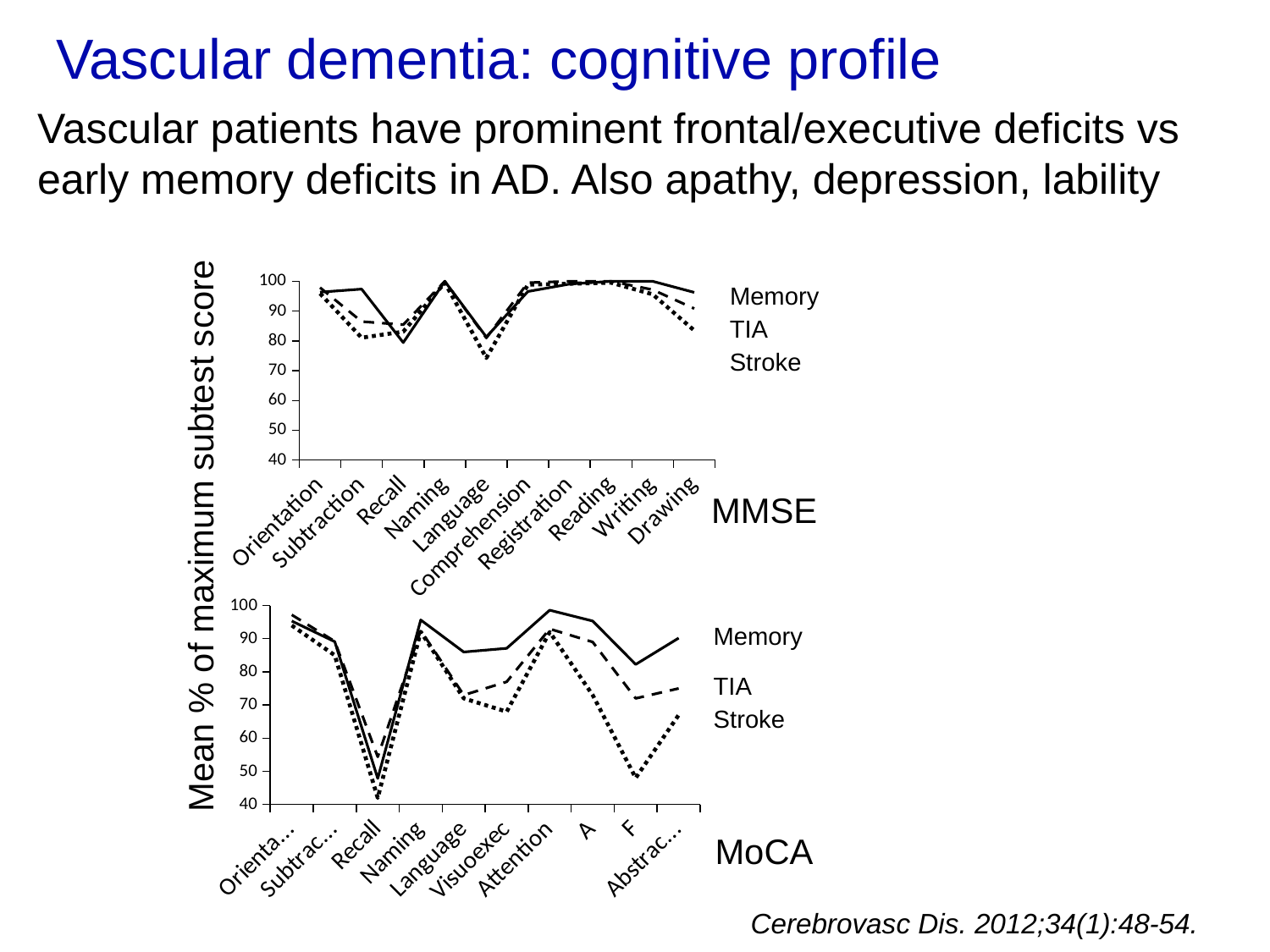
In the MoCA chart, is the Stroke value for Recall greater or less than 50? less In the MMSE chart, which series has the larger value for Language, Memory or Stroke? Memory In the MoCA chart, is the Stroke value for F greater or less than 60? less What is the label on the shared y axis of the two charts? Mean % of maximum subtest score How many subtests are plotted along the x axis of the MMSE chart? 10 In the MMSE chart, is the Stroke value for Language greater or less than 80? less In the MMSE chart, which subtest has the lowest value for the Stroke series? Language In the MoCA chart, which series has the larger value for F, Memory or Stroke? Memory What kind of chart is the MMSE chart at the top of the slide? line chart How many series does the legend of the MoCA chart list? 3 In the MoCA chart, which subtest has the lowest value for the Stroke series? Recall